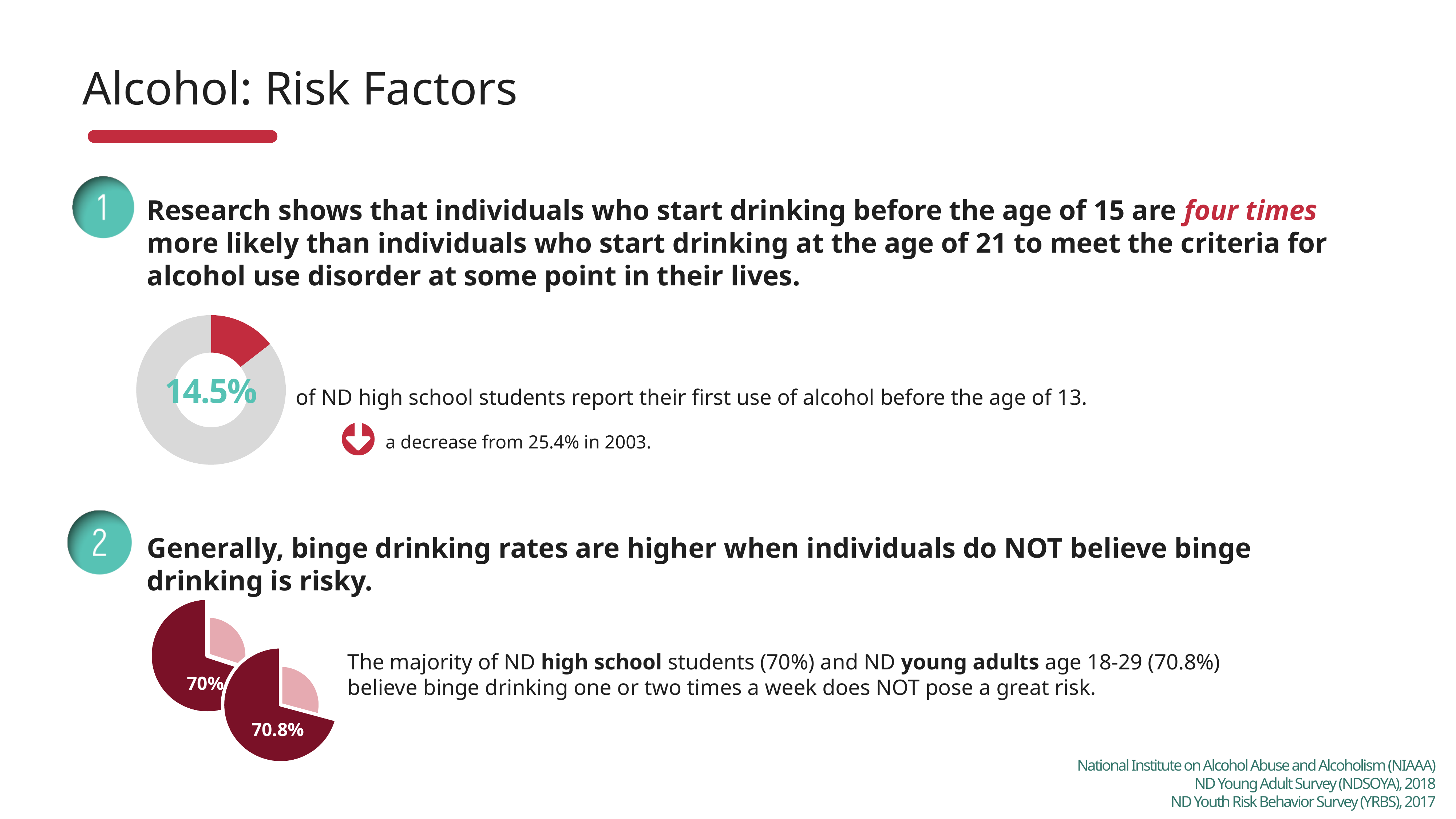
How many pie charts are shown under point 2? 2 In the donut chart under point 1, what percentage of ND high school students report their first use of alcohol before the age of 13? 14.5% In the donut chart under point 1, what share of the ring is filled in red? 14.5% In the pie charts under point 2, what percentage of ND young adults age 18-29 believe binge drinking one or two times a week does NOT pose a great risk? 70.8% What colour is the highlighted slice in the donut chart under point 1? red According to the annotation next to the donut chart under point 1, did the value increase or decrease from 2003? decrease In the pie charts under point 2, which group has the larger share: ND high school students or ND young adults age 18-29? ND young adults age 18-29 According to the annotation next to the donut chart under point 1, what was the value in 2003? 25.4% How many charts are on the slide in total? 3 In the pie charts under point 2, what is the difference between the young adults' value and the high school students' value? 0.8 percentage points In the pie charts under point 2, what percentage of ND high school students believe binge drinking one or two times a week does NOT pose a great risk? 70% What kind of chart is used under point 1 to show the 14.5% figure? donut chart